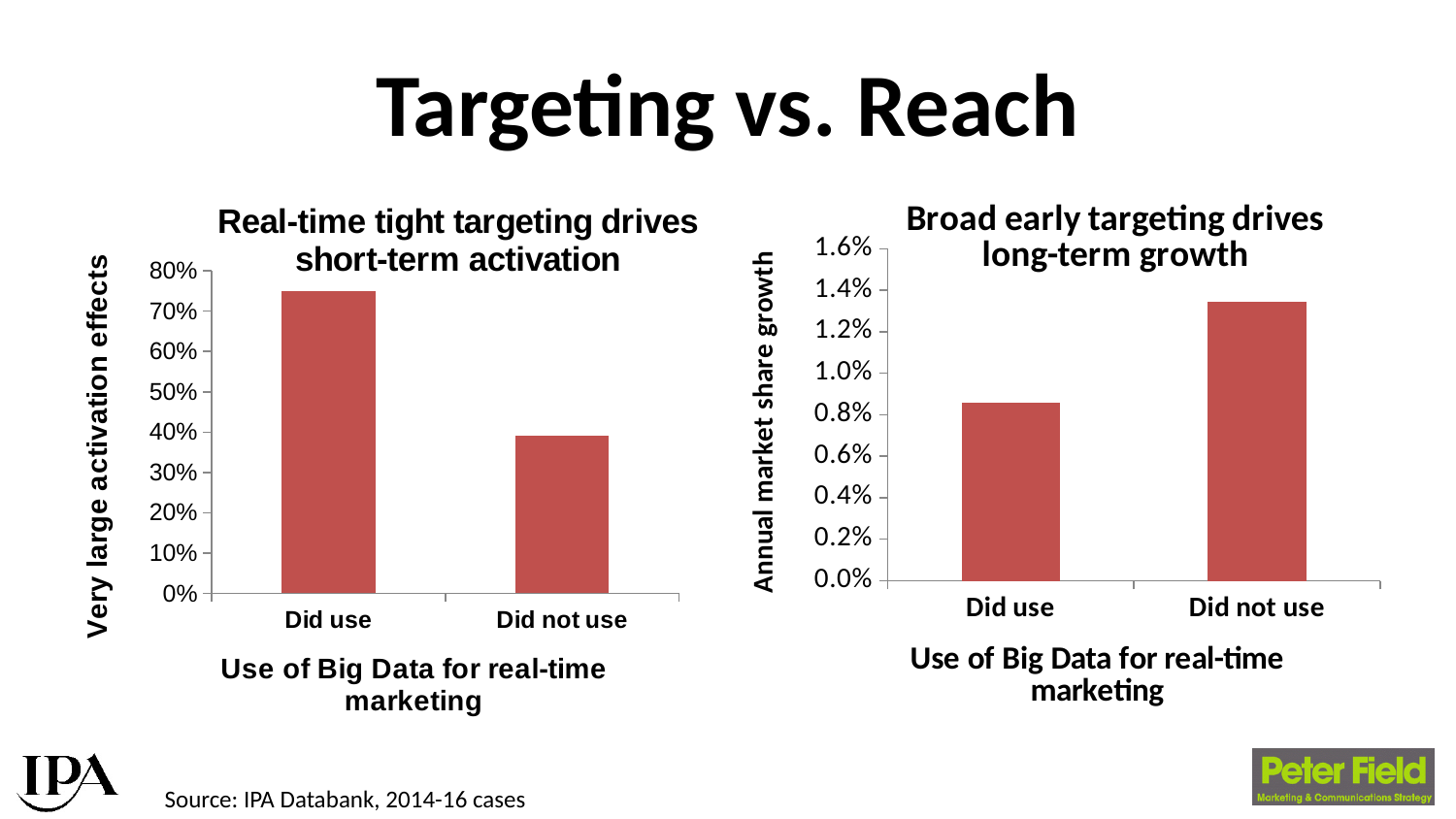
In the right chart, is the value for 'Did not use' greater or less than 1.2%? greater In the right chart, is the value for 'Did use' greater or less than 1.0%? less In the left chart, is the value for 'Did use' greater or less than 70%? greater What kind of chart is the right chart, 'Broad early targeting drives long-term growth'? bar chart In the left chart, 'Real-time tight targeting drives short-term activation', which category has the lower value? Did not use In the right chart, 'Broad early targeting drives long-term growth', which category has the higher value? Did not use How many categories are shown on the x axis of the left chart? 2 In the right chart, 'Broad early targeting drives long-term growth', which category has the lower value? Did use In the left chart, 'Real-time tight targeting drives short-term activation', which category has the higher value? Did use In the right chart, is the value for 'Did not use' larger or smaller than the value for 'Did use'? larger What is the y-axis label of the right chart? Annual market share growth